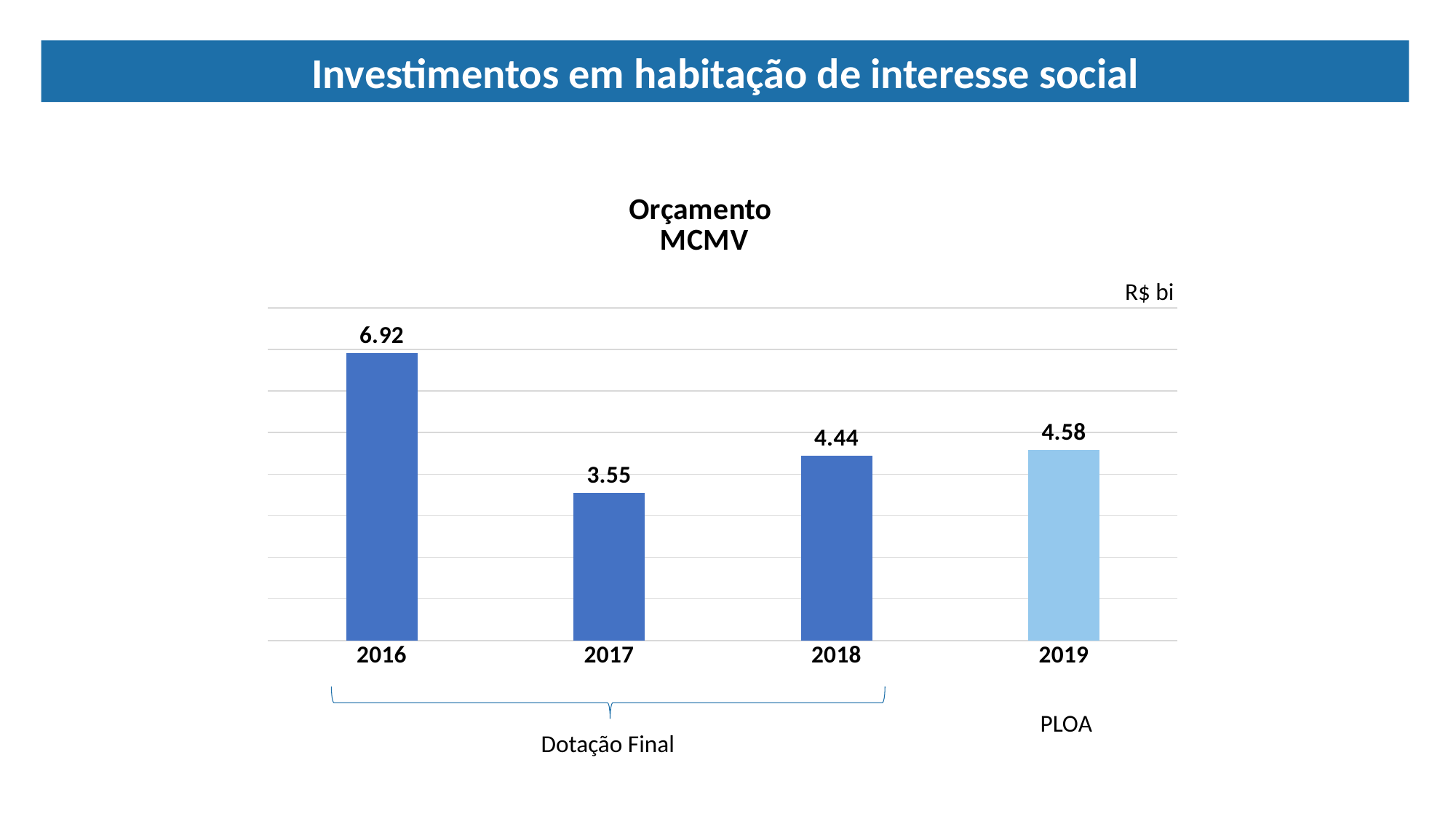
What is the value for 2016 in the Orçamento MCMV chart? 6.92 Which is larger in the Orçamento MCMV chart, the value for 2018 or the value for 2017? 2018 What is the value for 2017 in the Orçamento MCMV chart? 3.55 What unit is indicated for the values in the Orçamento MCMV chart? R$ bi What is the value for 2018 in the Orçamento MCMV chart? 4.44 What is the difference between the 2019 and 2018 values in the Orçamento MCMV chart? 0.14 Which year has the highest value in the Orçamento MCMV chart? 2016 What is the difference between the 2016 and 2017 values in the Orçamento MCMV chart? 3.37 What is the value for 2019 in the Orçamento MCMV chart? 4.58 Which year has the lowest value in the Orçamento MCMV chart? 2017 How many years are shown in the Orçamento MCMV chart? 4 What kind of chart is the Orçamento MCMV chart? Bar chart